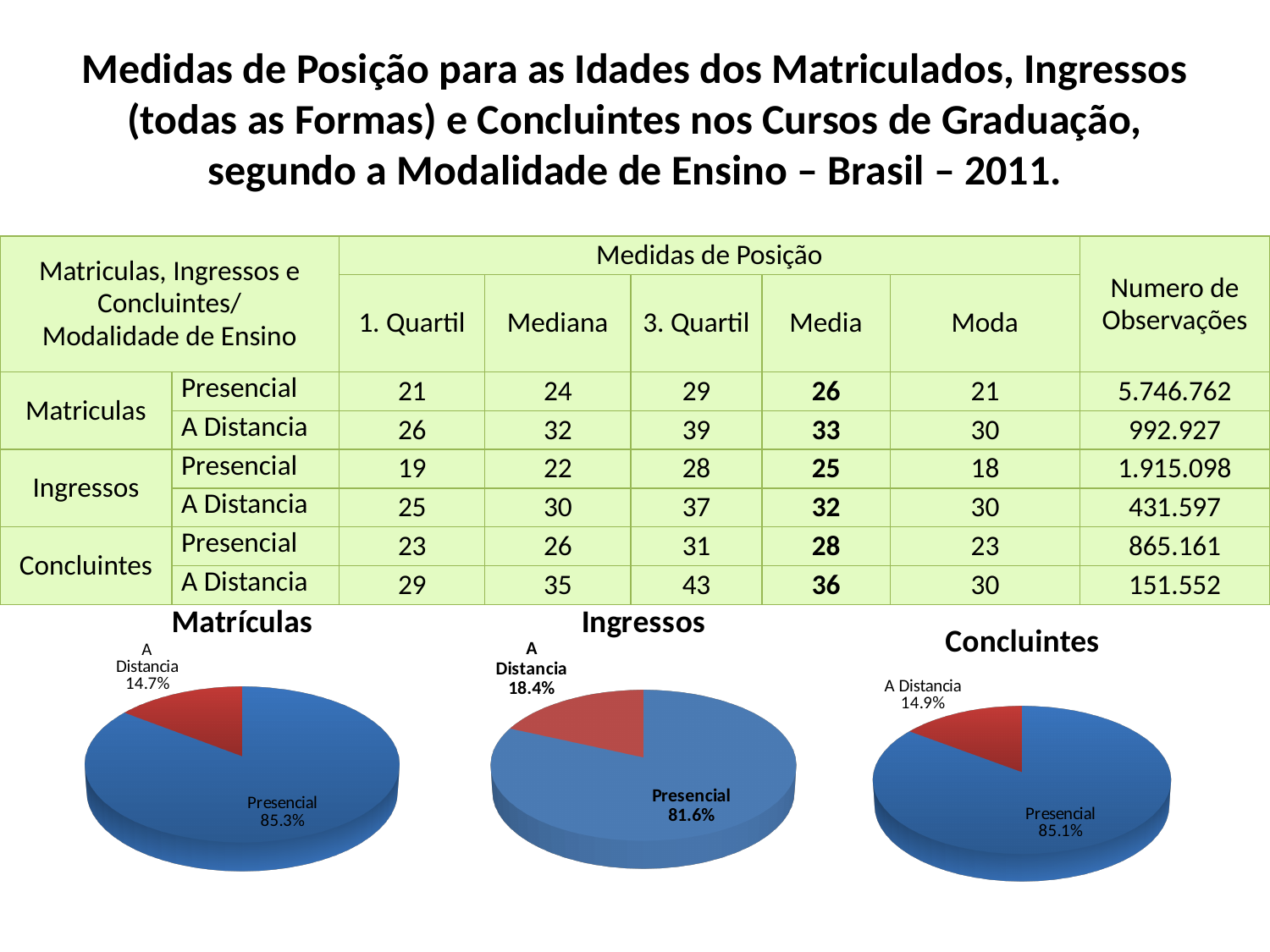
In the Concluintes pie chart, what share does A Distancia have? 14.9% In the Concluintes pie chart, what share does Presencial have? 85.1% In the Ingressos pie chart, what share does A Distancia have? 18.4% Which chart shows a larger A Distancia share, Ingressos or Concluintes? Ingressos In the Matrículas pie chart, what is the difference between the Presencial and A Distancia shares? 70.6% How many slices does the Matrículas pie chart have? 2 In the Concluintes pie chart, which slice is the smallest? A Distancia In the Ingressos pie chart, which slice is the largest? Presencial What type of chart is the Concluintes chart? Pie chart